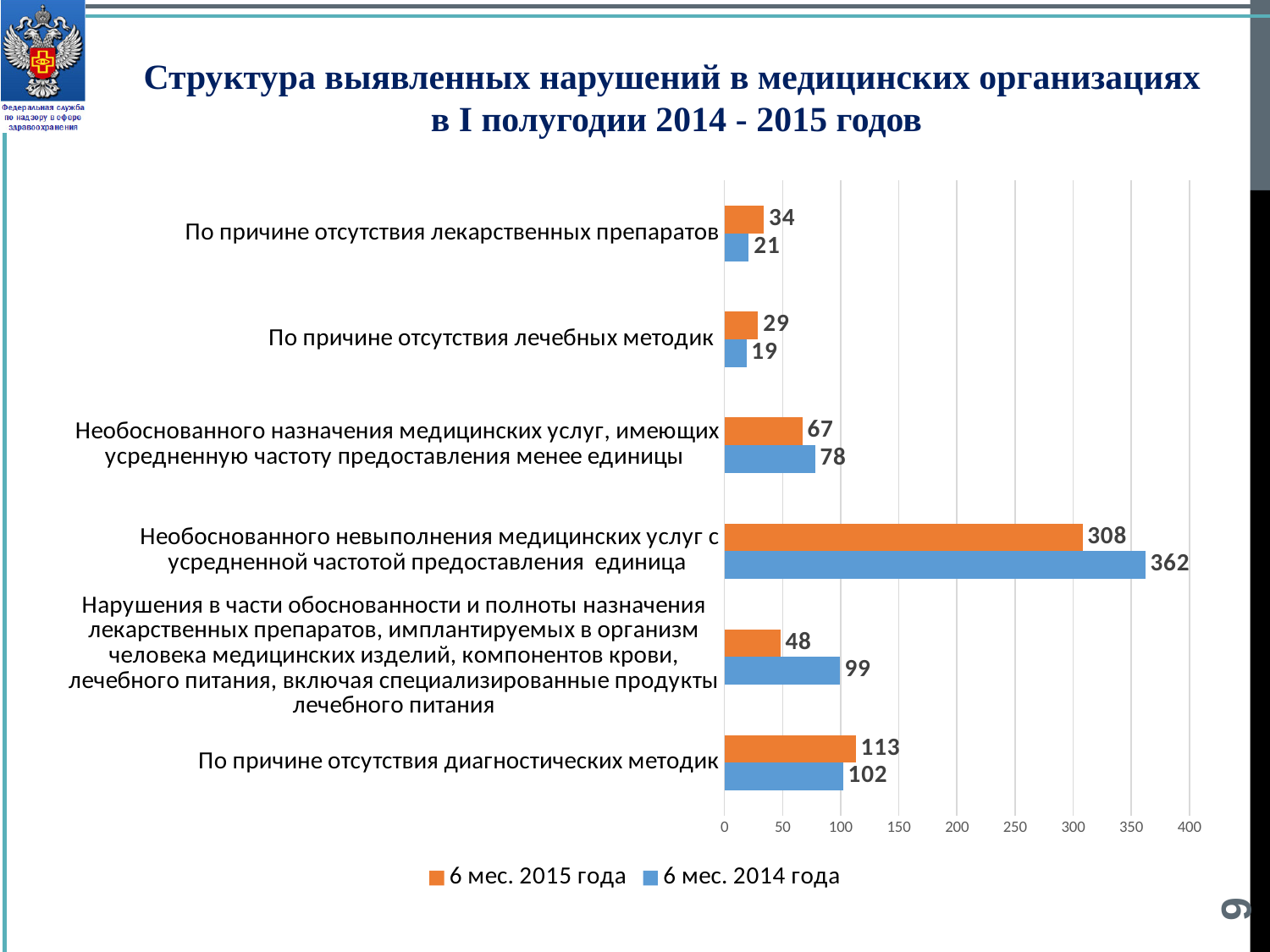
How many categories are shown on the chart? 6 How many series does the legend list? 2 For "Необоснованного назначения медицинских услуг, имеющих усредненную частоту предоставления менее единицы", which series has the larger value: "6 мес. 2015 года" or "6 мес. 2014 года"? 6 мес. 2014 года Which colour represents the "6 мес. 2015 года" series? Orange Is the "6 мес. 2014 года" value for "Необоснованного невыполнения медицинских услуг с усредненной частотой предоставления единица" greater or less than 350? greater What is the value for "По причине отсутствия диагностических методик" in the "6 мес. 2015 года" series? 113 Which category has the lowest value in the "6 мес. 2015 года" series? По причине отсутствия лечебных методик Which category has the highest value in the "6 мес. 2014 года" series? Необоснованного невыполнения медицинских услуг с усредненной частотой предоставления единица What is the value for "По причине отсутствия лекарственных препаратов" in the "6 мес. 2015 года" series? 34 What is the difference between the "6 мес. 2014 года" and "6 мес. 2015 года" values for "Необоснованного невыполнения медицинских услуг с усредненной частотой предоставления единица"? 54 What type of chart is shown on the slide? Bar chart What is the value for "По причине отсутствия лечебных методик" in the "6 мес. 2014 года" series? 19